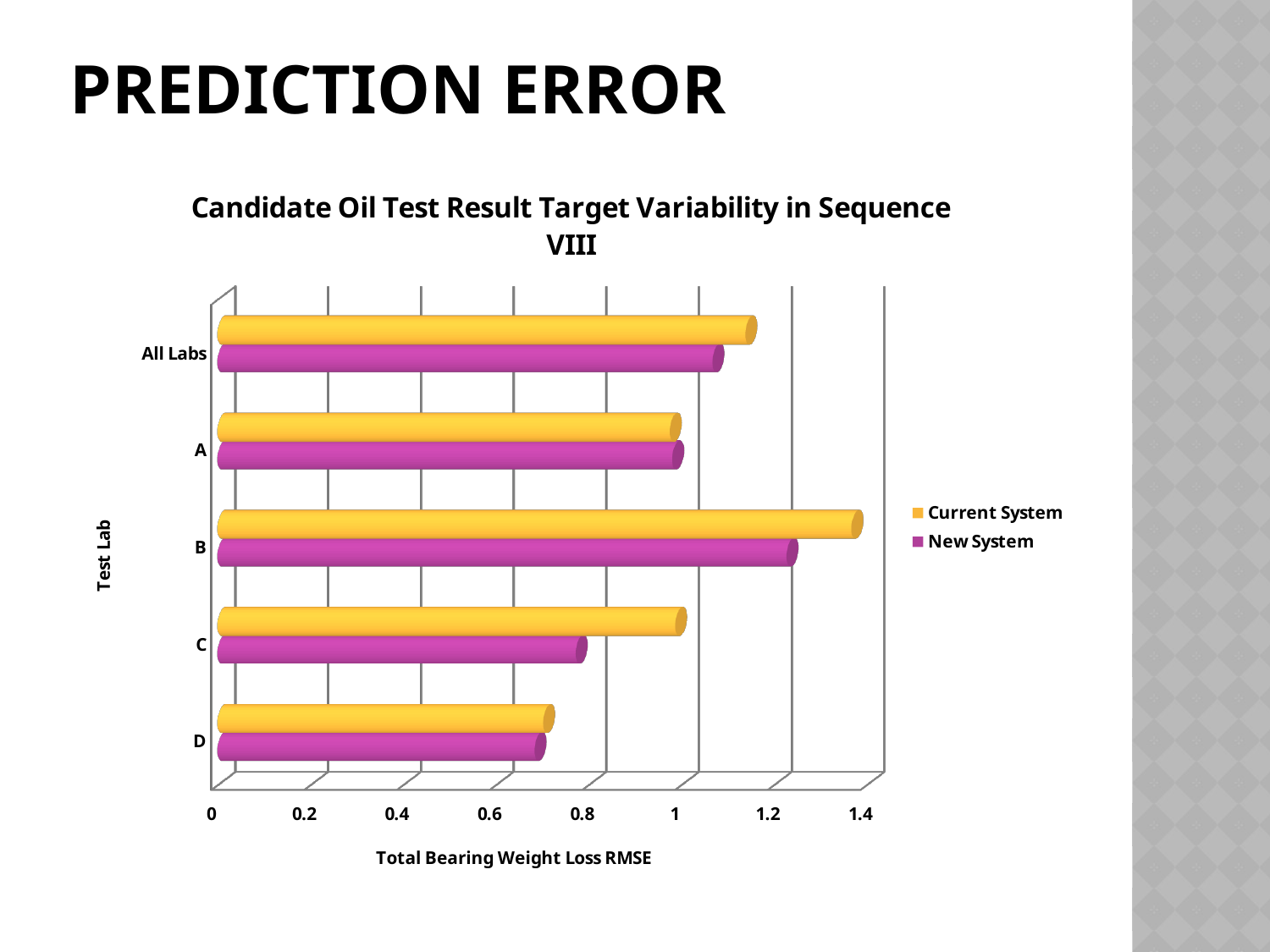
For test lab C, which is larger: the Current System value or the New System value? Current System Which test lab has the highest Current System value? B Which test lab has the lowest New System value? D How many test labs (categories) are plotted on the chart? 5 What is the title of the horizontal axis? Total Bearing Weight Loss RMSE For All Labs, which is larger: the Current System value or the New System value? Current System How many series does the legend list? 2 What kind of chart is shown on the slide? bar chart Which test lab has the lowest Current System value? D Is the Current System value for test lab B greater or less than 1.2? greater Is the New System value for test lab C greater or less than 0.8? less Which test lab has the highest New System value? B